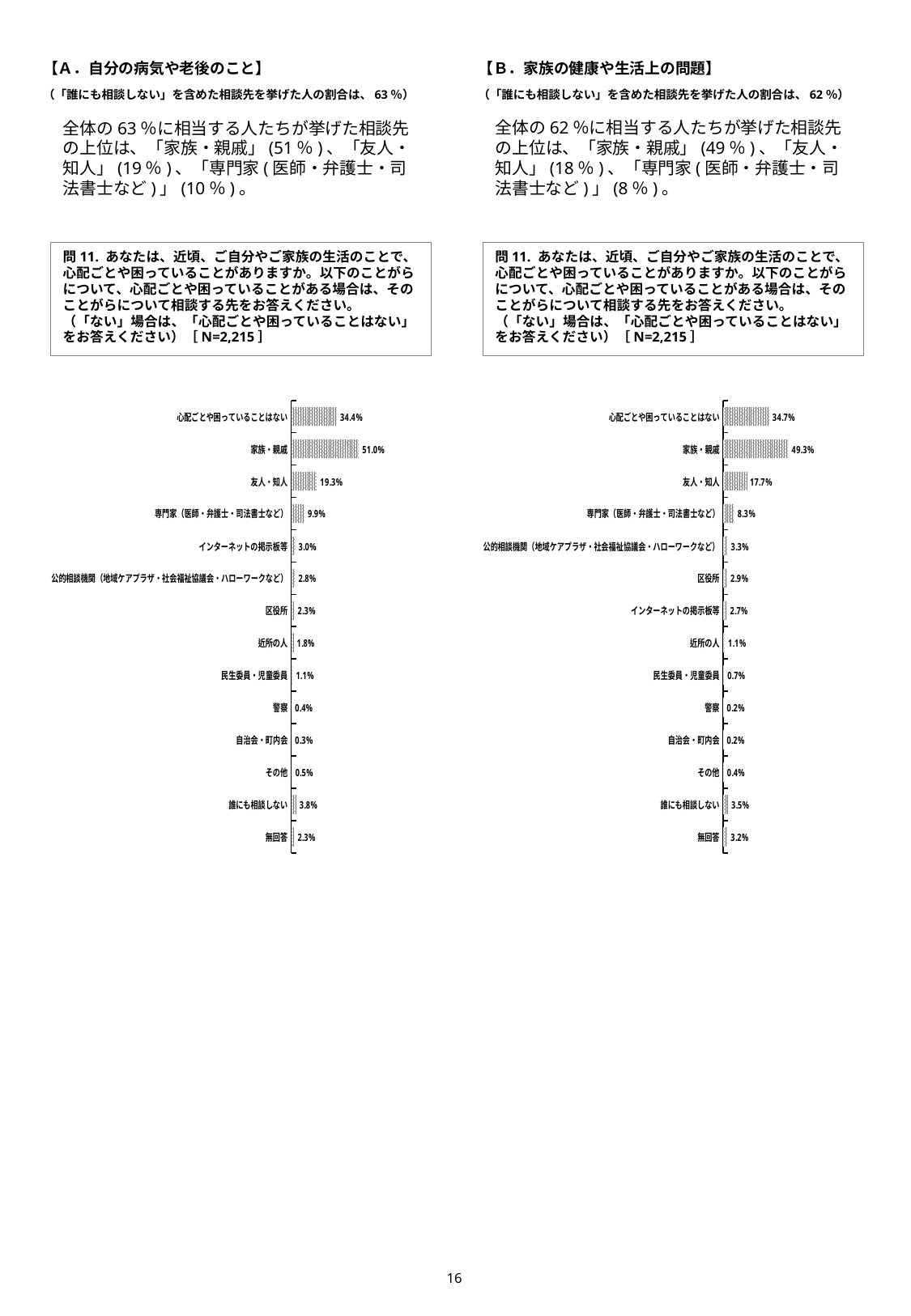
In the right chart (B. 家族の健康や生活上の問題), what is the value for 専門家（医師・弁護士・司法書士など）? 8.3% In the left chart (A. 自分の病気や老後のこと), what is the difference between 家族・親戚 and 友人・知人? 31.7% How many categories are shown in the right chart (B. 家族の健康や生活上の問題)? 14 In the right chart (B. 家族の健康や生活上の問題), which category has the lowest value? 警察 and 自治会・町内会 (both 0.2%) In the left chart (A. 自分の病気や老後のこと), which is larger: インターネットの掲示板等 or 公的相談機関? インターネットの掲示板等 In the left chart (A. 自分の病気や老後のこと), which category has the highest value? 家族・親戚 In the right chart (B. 家族の健康や生活上の問題), what is the difference between 心配ごとや困っていることはない and 家族・親戚? 14.6% In the right chart (B. 家族の健康や生活上の問題), what is the value for 友人・知人? 17.7% In the left chart (A. 自分の病気や老後のこと), what is the value for 家族・親戚? 51.0% In the left chart (A. 自分の病気や老後のこと), what is the value for 誰にも相談しない? 3.8% In the right chart (B. 家族の健康や生活上の問題), what is the value for 無回答? 3.2% What kind of chart is the left chart (A. 自分の病気や老後のこと)? Bar chart